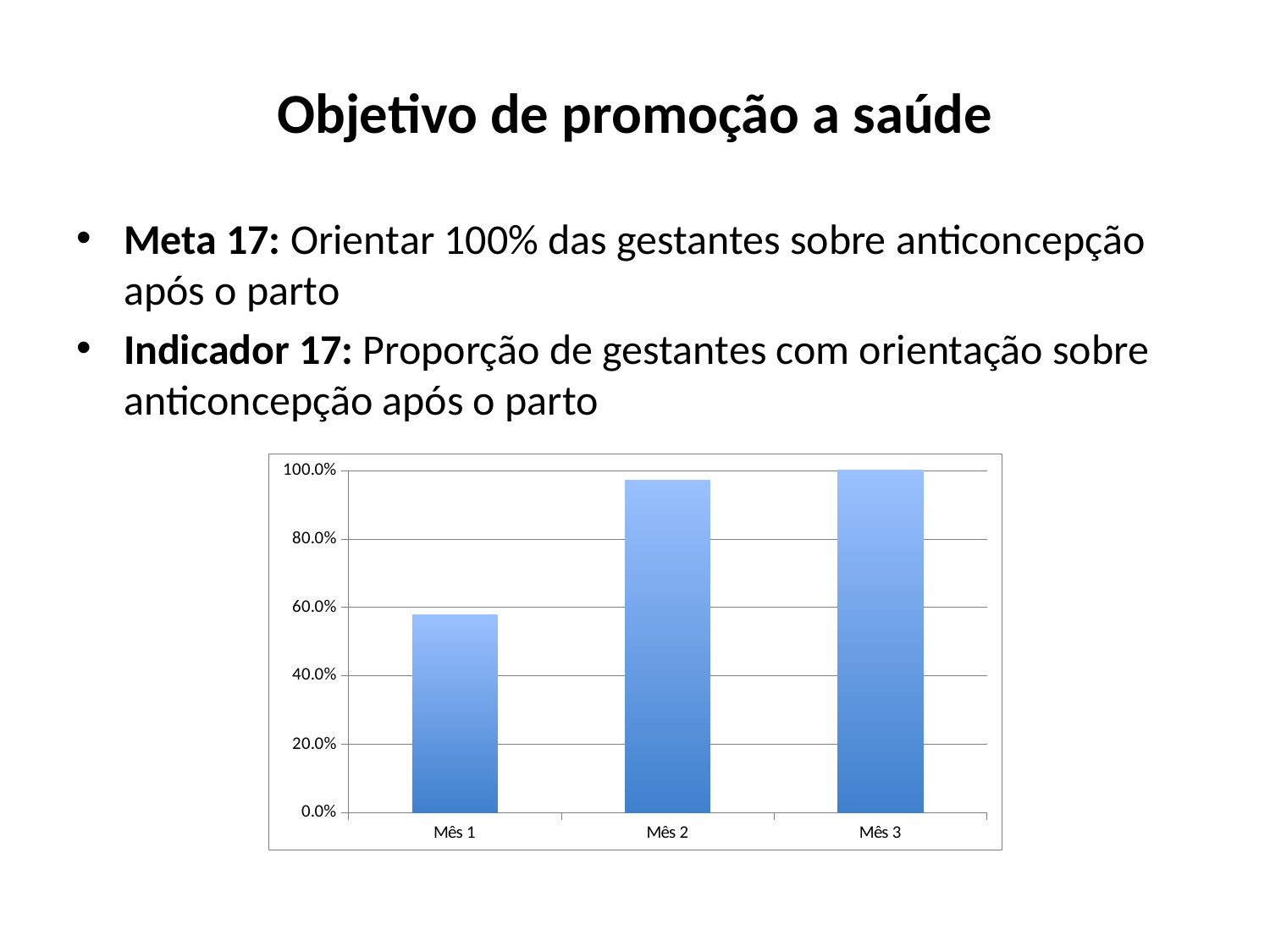
What is the highest tick label on the y axis of the chart? 100.0% What is the label of the first category on the x axis? Mês 1 Is the value for Mês 1 greater or less than 40.0%? greater What value does the bar for Mês 3 reach on the y axis? 100.0% Which is larger, the value for Mês 1 or the value for Mês 2? Mês 2 What kind of chart is shown on the slide? bar chart Which month has the lowest bar in the chart? Mês 1 Do the values rise or fall from Mês 1 to Mês 3? rise How many categories are shown on the x axis of the chart? 3 Which month has the highest bar in the chart? Mês 3 Is the value for Mês 1 greater or less than 60.0%? less Is the value for Mês 2 greater or less than 80.0%? greater